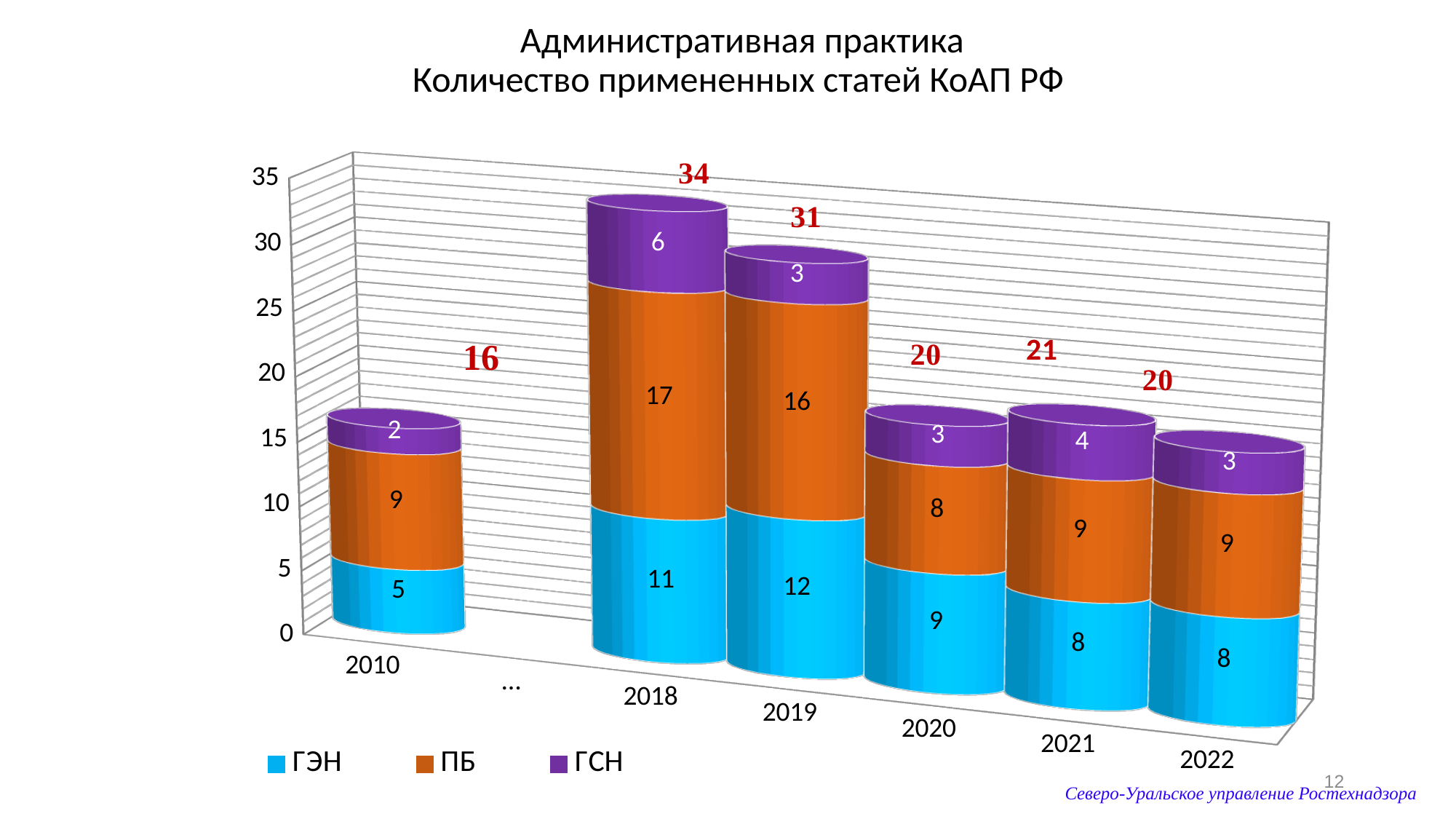
Which series is shown in purple in the legend? ГСН What is the difference between the ГЭН values for 2019 and 2022? 4 Which year has the highest total? 2018 What type of chart is shown on the slide? stacked bar chart What is the total of the stacked bar for 2010? 16 What is the value for ГЭН in 2019? 12 How many series does the legend list? 3 Which is larger, the ПБ value for 2020 or the ПБ value for 2021? 2021 What is the value for ПБ in 2018? 17 What is the value for ГСН in 2021? 4 Which year has the lowest total? 2010 What is the total of the stacked bar for 2018? 34